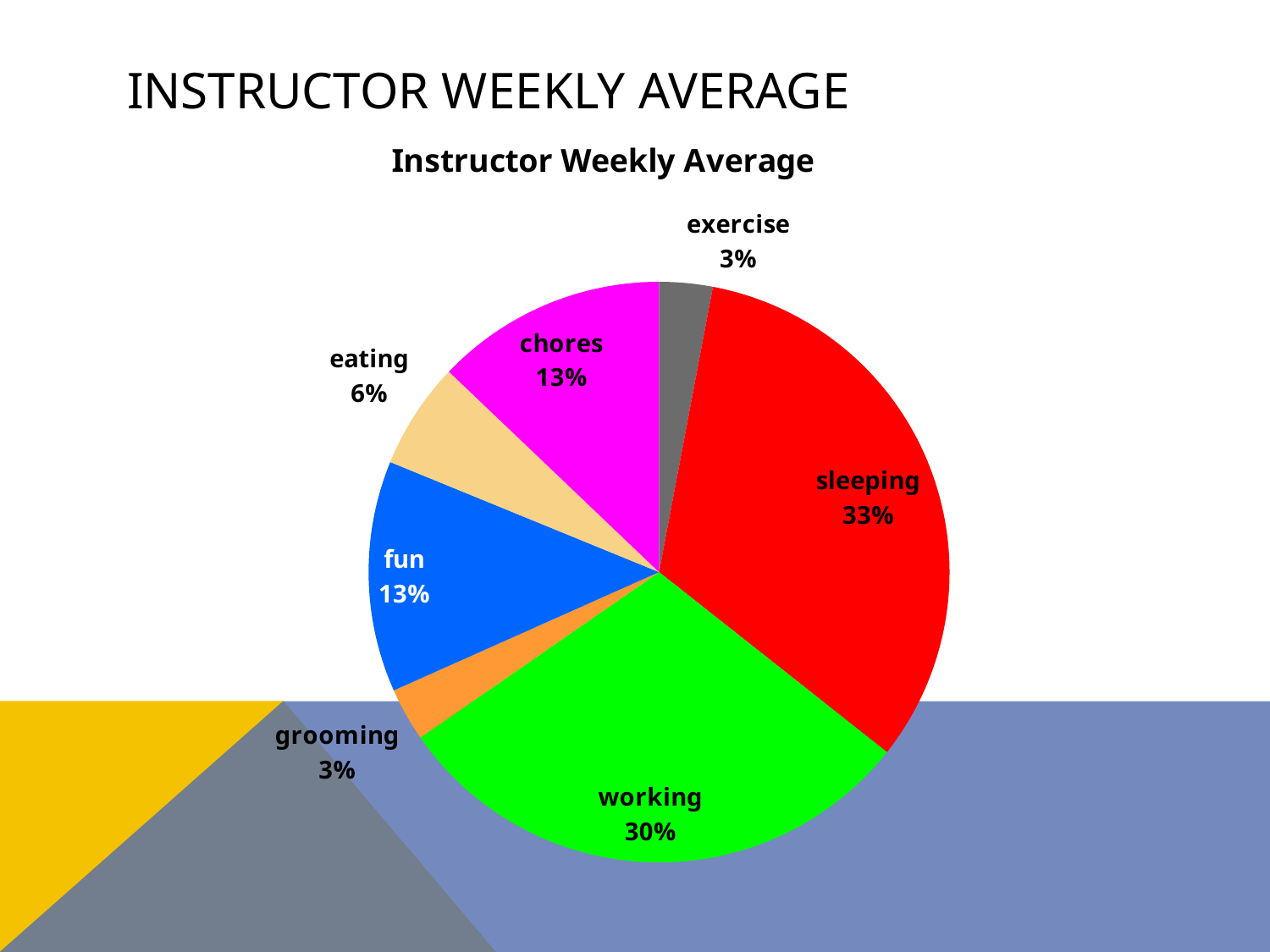
What colour is the working slice? green How many categories does the pie chart show? 7 Which is larger, the share for chores or the share for eating? chores What is the value for eating? 6% What share of the pie does sleeping take? 33% What is the value for working? 30% What is the difference between the sleeping and working shares? 3% Which category has the largest slice? sleeping What is the difference between the fun and exercise shares? 10% What kind of chart is shown on the slide? pie chart What is the value for grooming? 3% What is the title of the chart? Instructor Weekly Average